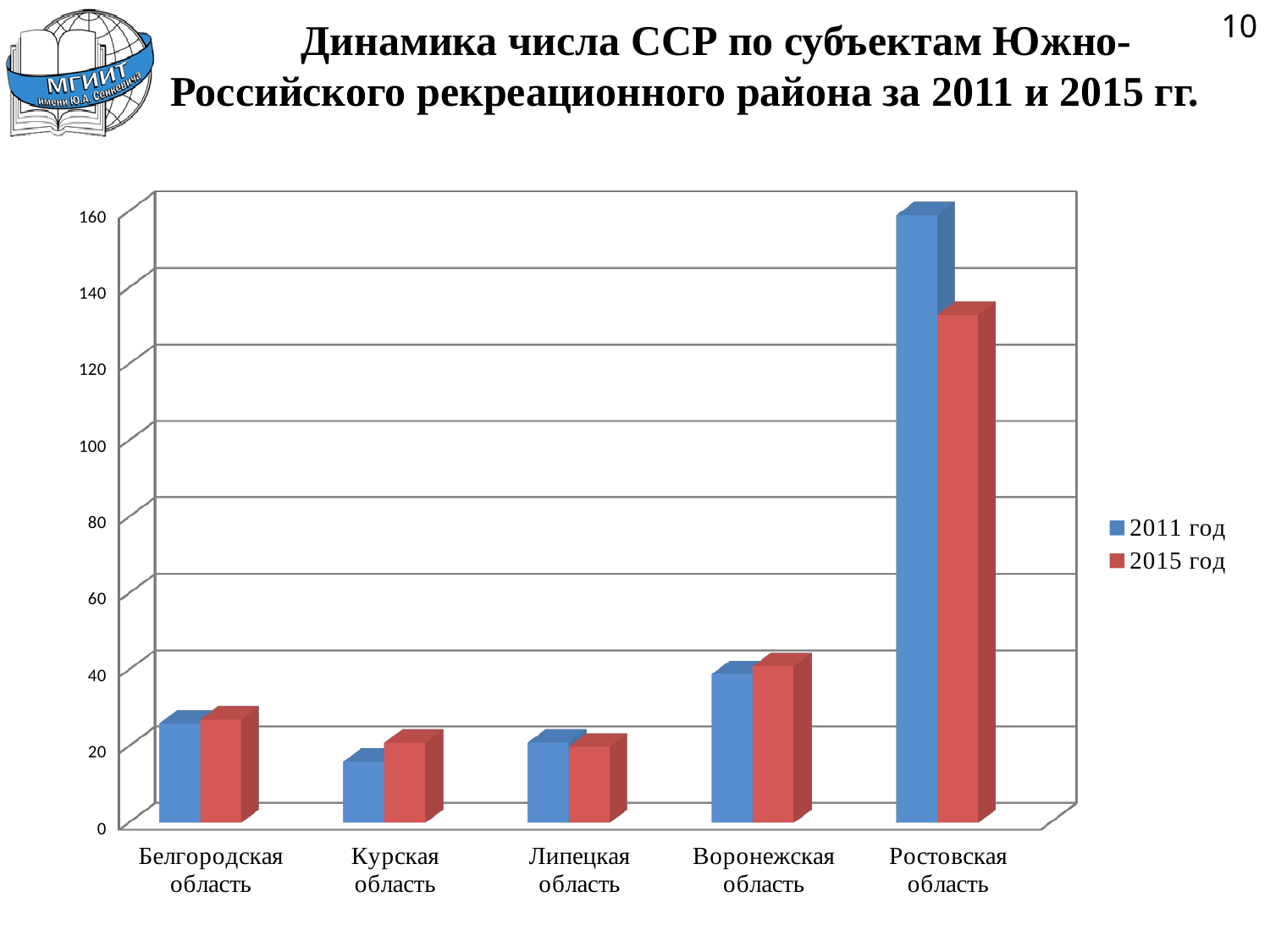
Which region has the highest value for 2011 год? Ростовская область Which region has the lowest value for 2011 год? Курская область How many regions (categories) are shown on the x axis of the chart? 5 Is the value for Ростовская область in 2015 год greater or less than 140? less Is the value for Воронежская область in 2011 год greater or less than 60? less For Ростовская область, which is larger: the value for 2011 год or for 2015 год? 2011 год Is the value for Ростовская область in 2011 год greater or less than 140? greater What are the two series named in the chart's legend? 2011 год and 2015 год For Курская область, which is larger: the value for 2011 год or for 2015 год? 2015 год How many series does the chart's legend list? 2 Which region has the highest value for 2015 год? Ростовская область What kind of chart is shown on the slide? Bar chart